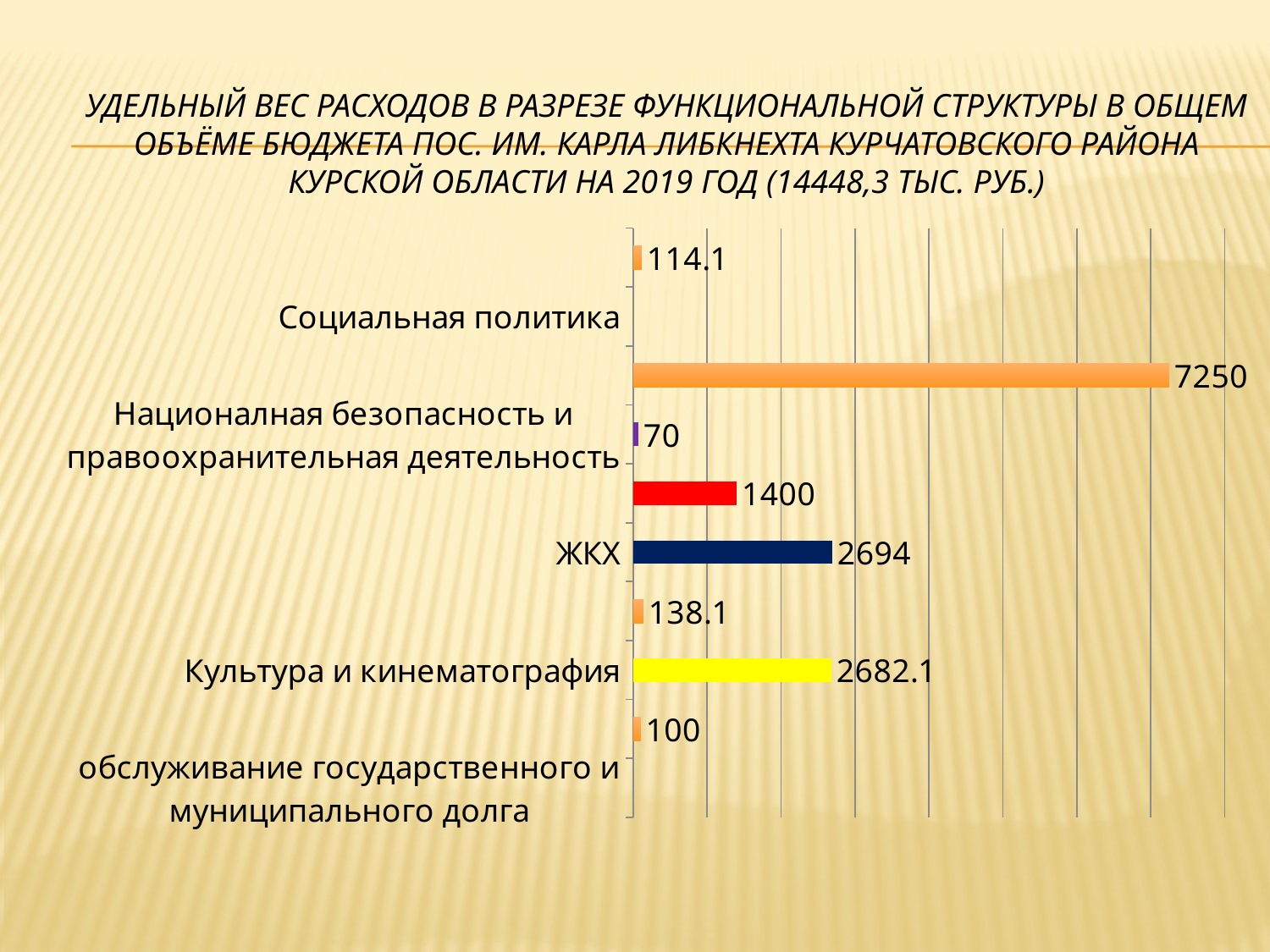
What is the difference between the largest value (7250) and the value for ЖКХ? 4556 What is the largest value shown on the chart? 7250 What type of chart is shown on the slide? bar chart What is the value for Националная безопасность и правоохранительная деятельность? 70 What is the value for ЖКХ? 2694 Which labelled category has the smallest value? Националная безопасность и правоохранительная деятельность What is the difference between the value for ЖКХ and the value for Культура и кинематография? 11.9 Which is larger, the value for ЖКХ or the value for Культура и кинематография? ЖКХ What total budget amount is stated in the chart title? 14448,3 тыс. руб. How many bars are plotted on the chart? 8 What colour is the bar for ЖКХ? dark blue What is the value for Культура и кинематография? 2682.1